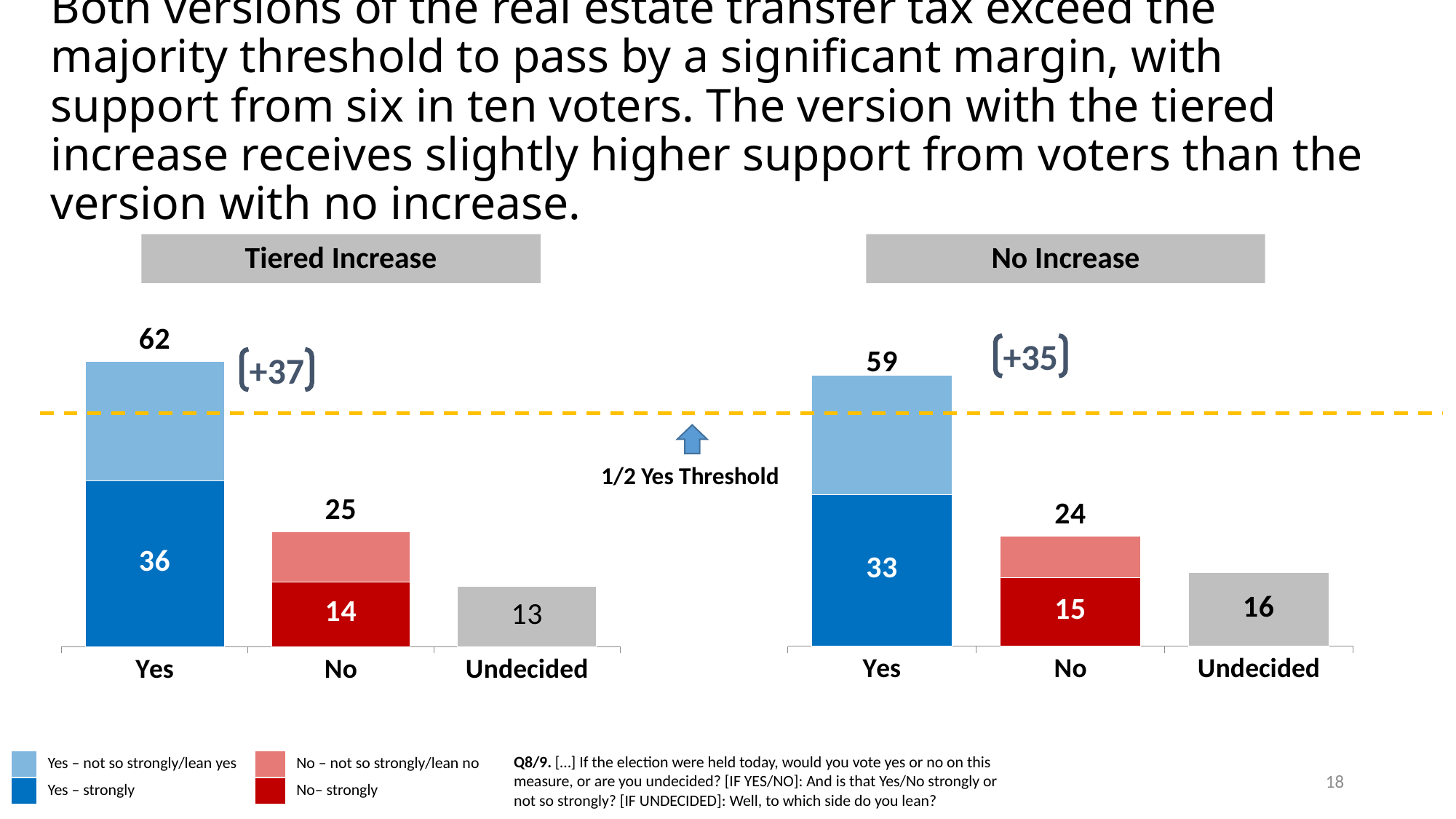
Which is larger: the Undecided value in the Tiered Increase chart or the Undecided value in the No Increase chart? No Increase In the Tiered Increase chart, what is the difference between the No total and the Undecided value? 12 In the No Increase chart, what is the value for Undecided? 16 What is the difference between the Yes total in the Tiered Increase chart and the Yes total in the No Increase chart? 3 In the No Increase chart, which category has the highest total value? Yes In the Tiered Increase chart, what is the value of the Yes – strongly segment? 36 In the No Increase chart, what is the value of the No – strongly segment? 15 In the No Increase chart, what is the total value of the Yes bar? 59 In the Tiered Increase chart, what is the total value of the Yes bar? 62 How many categories are shown on the x axis of the Tiered Increase chart? 3 How many entries does the legend at the bottom of the slide list? 4 In the Tiered Increase chart, which category has the lowest total value? Undecided